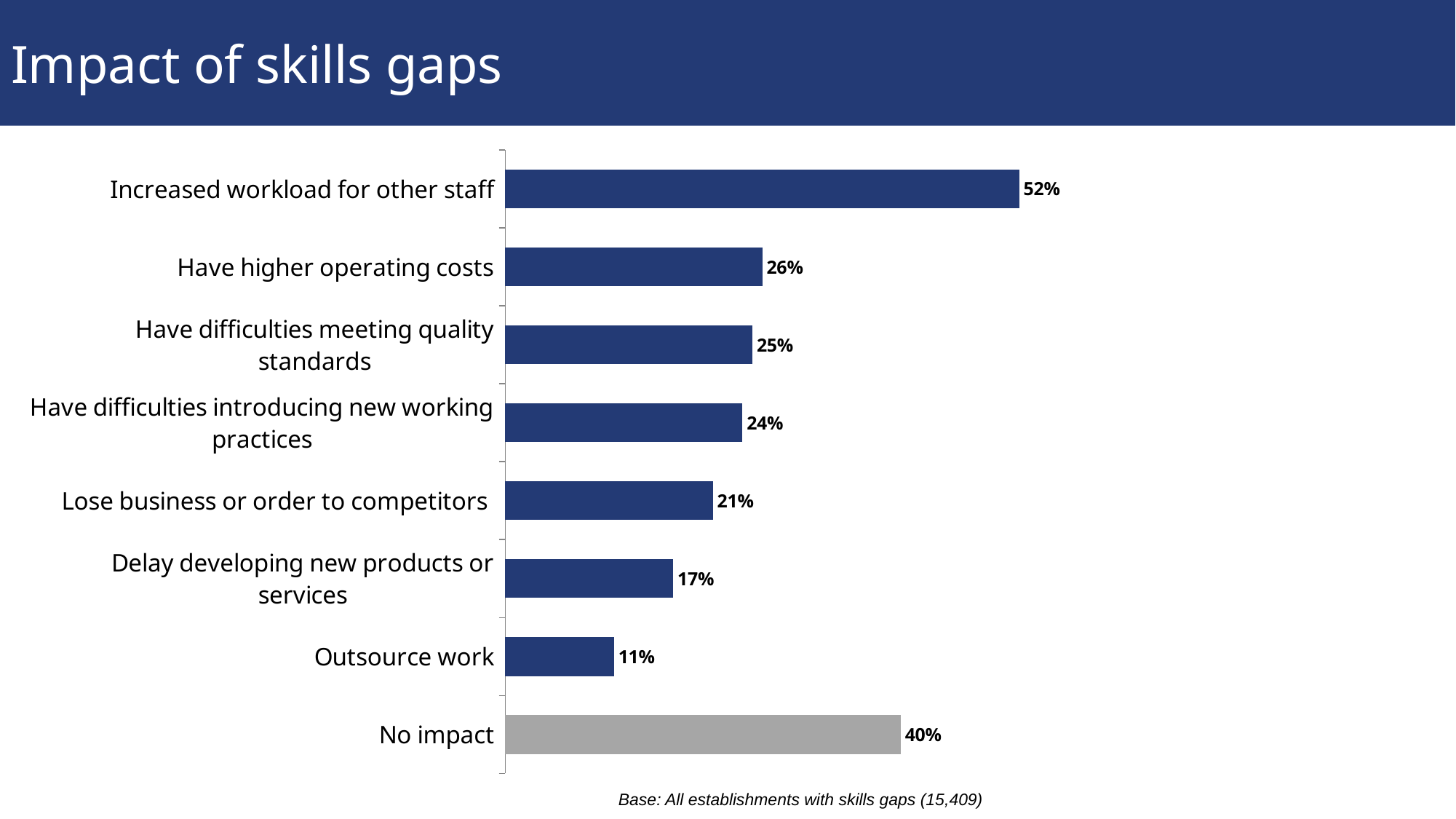
Which bar is shown in a different colour (grey) from the others? No impact Which category has the lowest value on the chart? Outsource work What is the value for 'Lose business or order to competitors'? 21% What is the difference between 'Have higher operating costs' and 'Delay developing new products or services'? 9% What is the value shown for 'Outsource work'? 11% Which category has the highest value on the chart? Increased workload for other staff What percentage of establishments reported increased workload for other staff as an impact of skills gaps? 52% What percentage of establishments reported no impact from skills gaps? 40% How many categories are shown on the chart? 8 What is the difference between the values for 'Increased workload for other staff' and 'No impact'? 12% Which is larger: the value for 'Have higher operating costs' or the value for 'Outsource work'? Have higher operating costs What kind of chart is shown on the slide? Bar chart